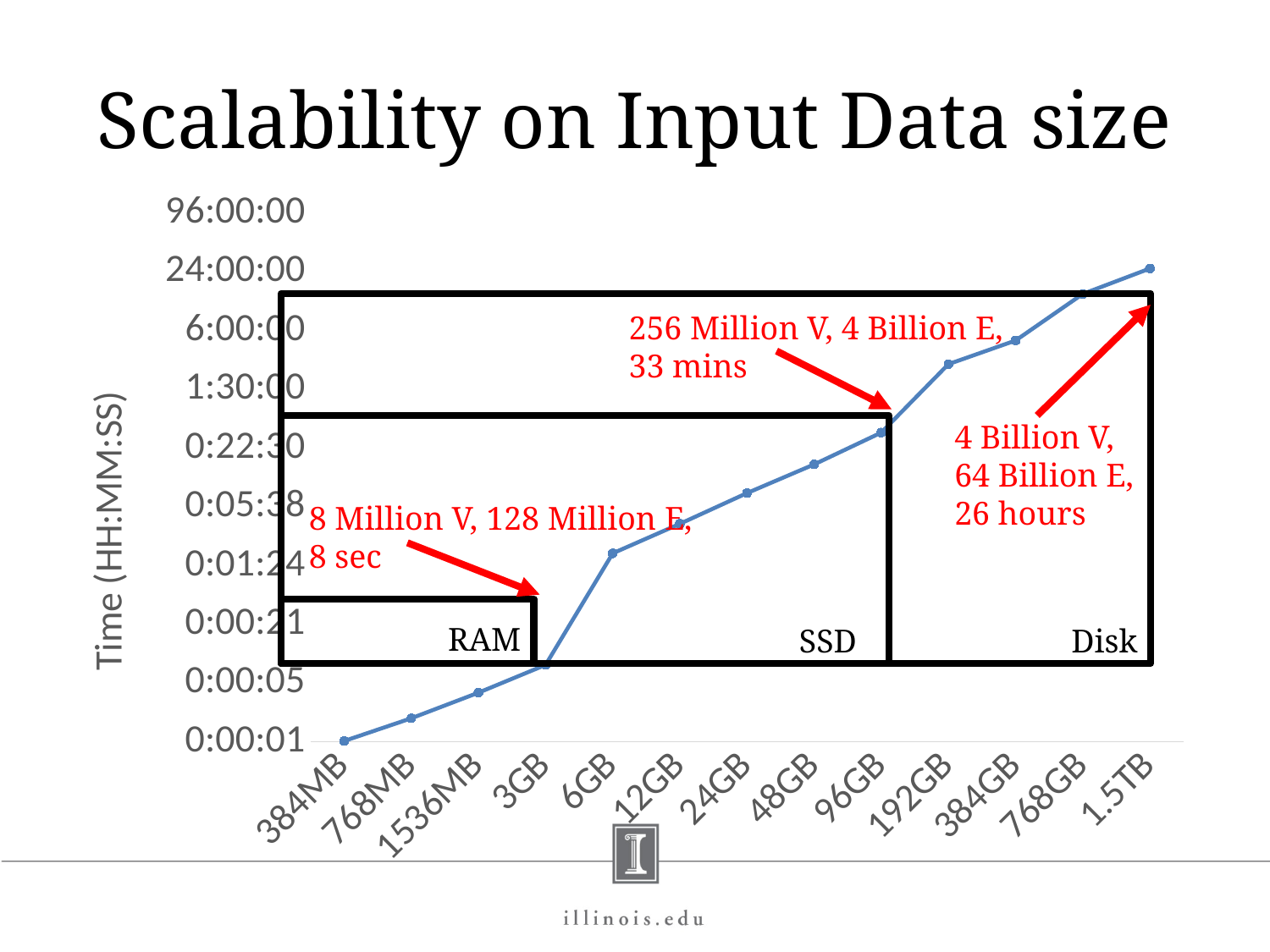
Is the time for 768GB greater or less than 24:00:00? less Is the time for 48GB greater or less than 0:05:38? greater Which has the larger time, 12GB or 192GB? 192GB According to the annotation, what is the time for the 96GB input (256 Million V, 4 Billion E)? 33 mins According to the annotation, what is the time for the 3GB input (8 Million V, 128 Million E)? 8 sec According to the annotation, what is the time for the 1.5TB input (4 Billion V, 64 Billion E)? 26 hours Which input data size has the lowest time? 384MB Do the plotted times rise or fall as the input data size increases along the x axis? rise Which input data size has the highest time? 1.5TB What is the title of the y axis? Time (HH:MM:SS) How many input data sizes are plotted along the x axis? 13 What kind of chart is shown on the slide? line chart